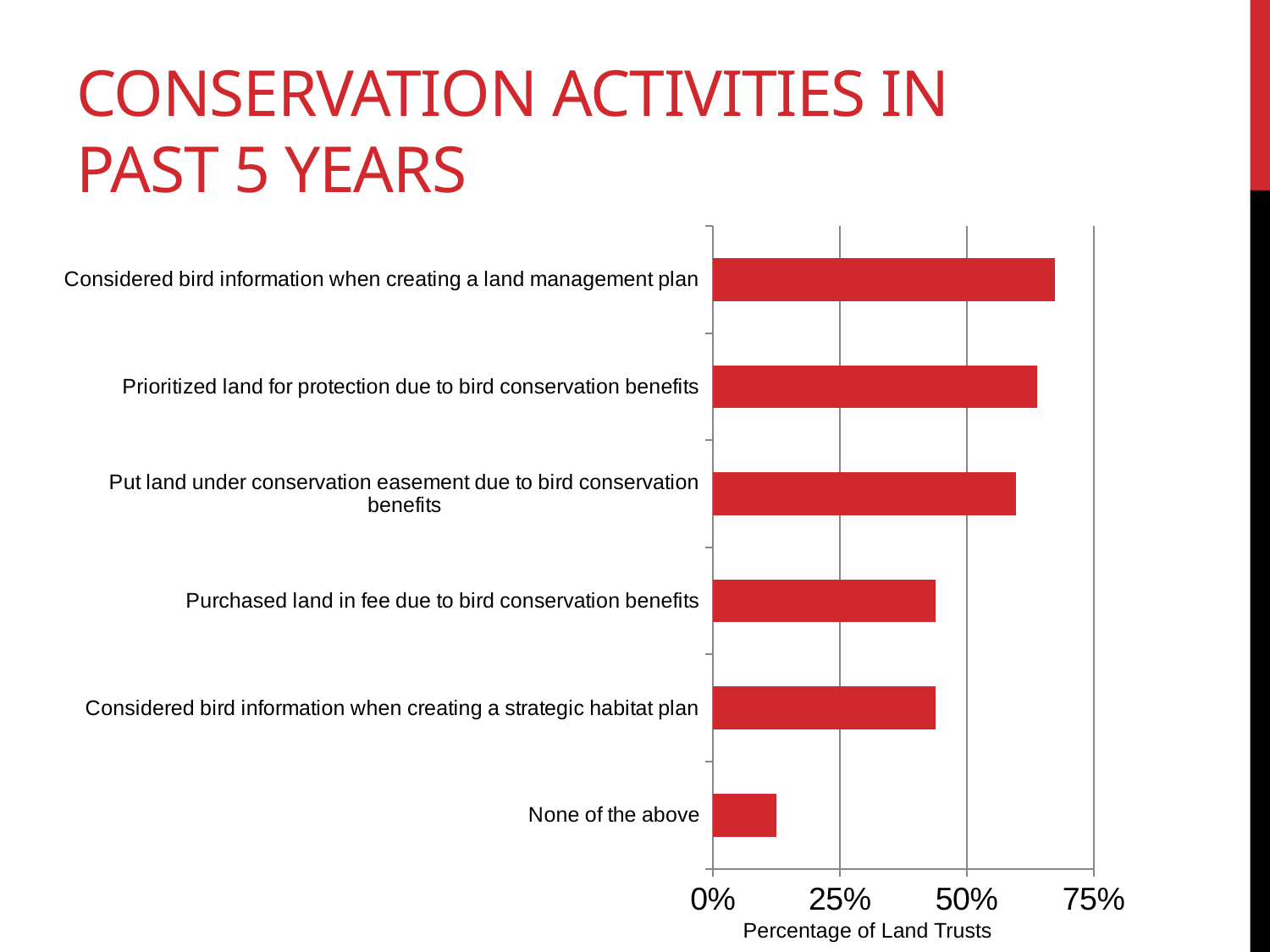
Is the value for "Considered bird information when creating a land management plan" greater or less than 50%? greater What is the label of the horizontal axis of the chart? Percentage of Land Trusts What kind of chart is shown on the slide? Bar chart What is the title of the slide containing the chart? CONSERVATION ACTIVITIES IN PAST 5 YEARS Which category has the lowest percentage of land trusts? None of the above Is the value for "Purchased land in fee due to bird conservation benefits" greater or less than 50%? less Which is larger: the value for "Prioritized land for protection due to bird conservation benefits" or for "None of the above"? Prioritized land for protection due to bird conservation benefits Is the value for "Considered bird information when creating a strategic habitat plan" greater or less than 25%? greater How many categories are plotted in the chart? 6 Which is larger: the value for "Put land under conservation easement due to bird conservation benefits" or for "Purchased land in fee due to bird conservation benefits"? Put land under conservation easement due to bird conservation benefits